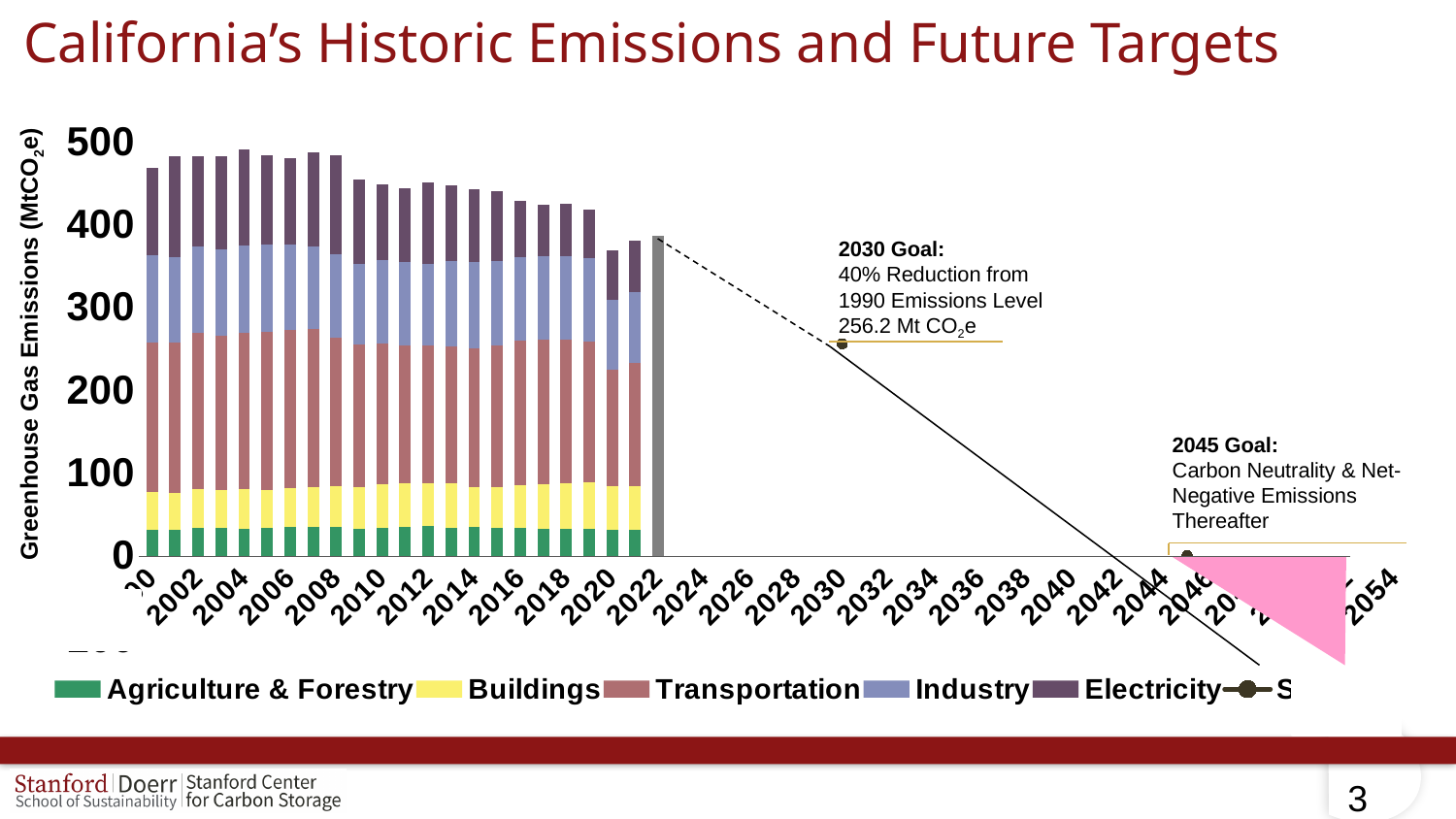
What kind of chart is used to show California's historic emissions? Stacked bar chart What does the 2045 Goal call for? Carbon Neutrality & Net-Negative Emissions Thereafter Which year between 2000 and 2022 has the lowest total emissions bar? 2020 Is the total emissions bar for 2012 greater or less than 400? greater Is the total emissions bar for 2020 greater or less than 400? less Do total emissions rise or fall from 2008 to 2020? fall What reduction does the 2030 Goal call for? 40% Reduction from 1990 Emissions Level In 2010, which sector segment is larger: Transportation or Buildings? Transportation Is the total emissions bar for 2020 greater or less than 300? greater What is the label on the y-axis? Greenhouse Gas Emissions (MtCO2e) What is the emissions level given for the 2030 Goal? 256.2 Mt CO2e Which sector is shown in yellow in the legend? Buildings